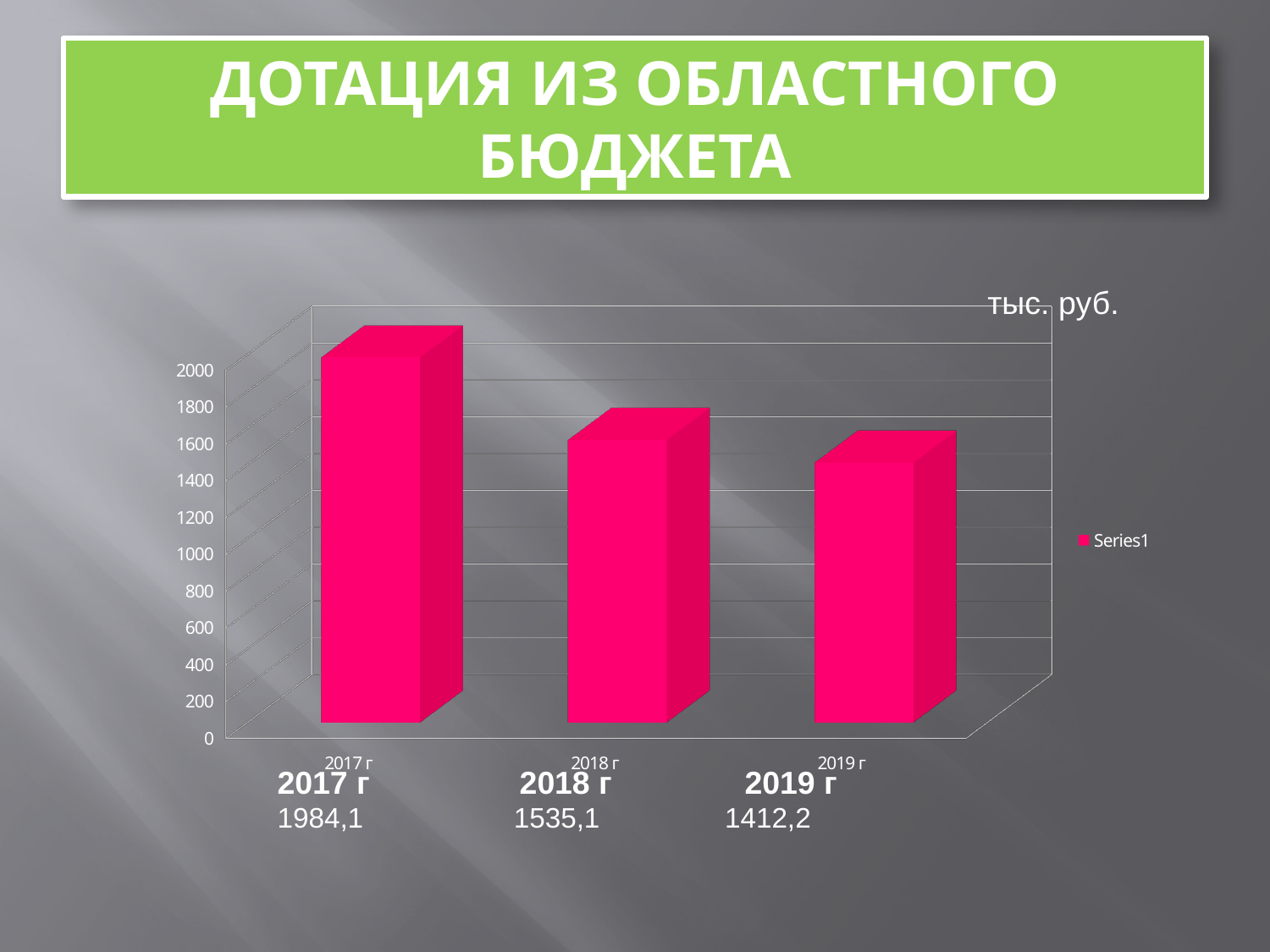
Is the value for 2019 г greater or less than 1600? less Do the values rise or fall from 2017 г to 2019 г? fall How many years are shown on the chart? 3 Which year has the lowest value? 2019 г What is the difference between the values for 2017 г and 2018 г? 449,0 What is the value for 2017 г? 1984,1 What is the difference between the values for 2018 г and 2019 г? 122,9 Which is larger, the value for 2018 г or the value for 2019 г? 2018 г Which year has the highest value? 2017 г What kind of chart is shown on the slide? bar chart What is the value for 2018 г? 1535,1 What is the value for 2019 г? 1412,2